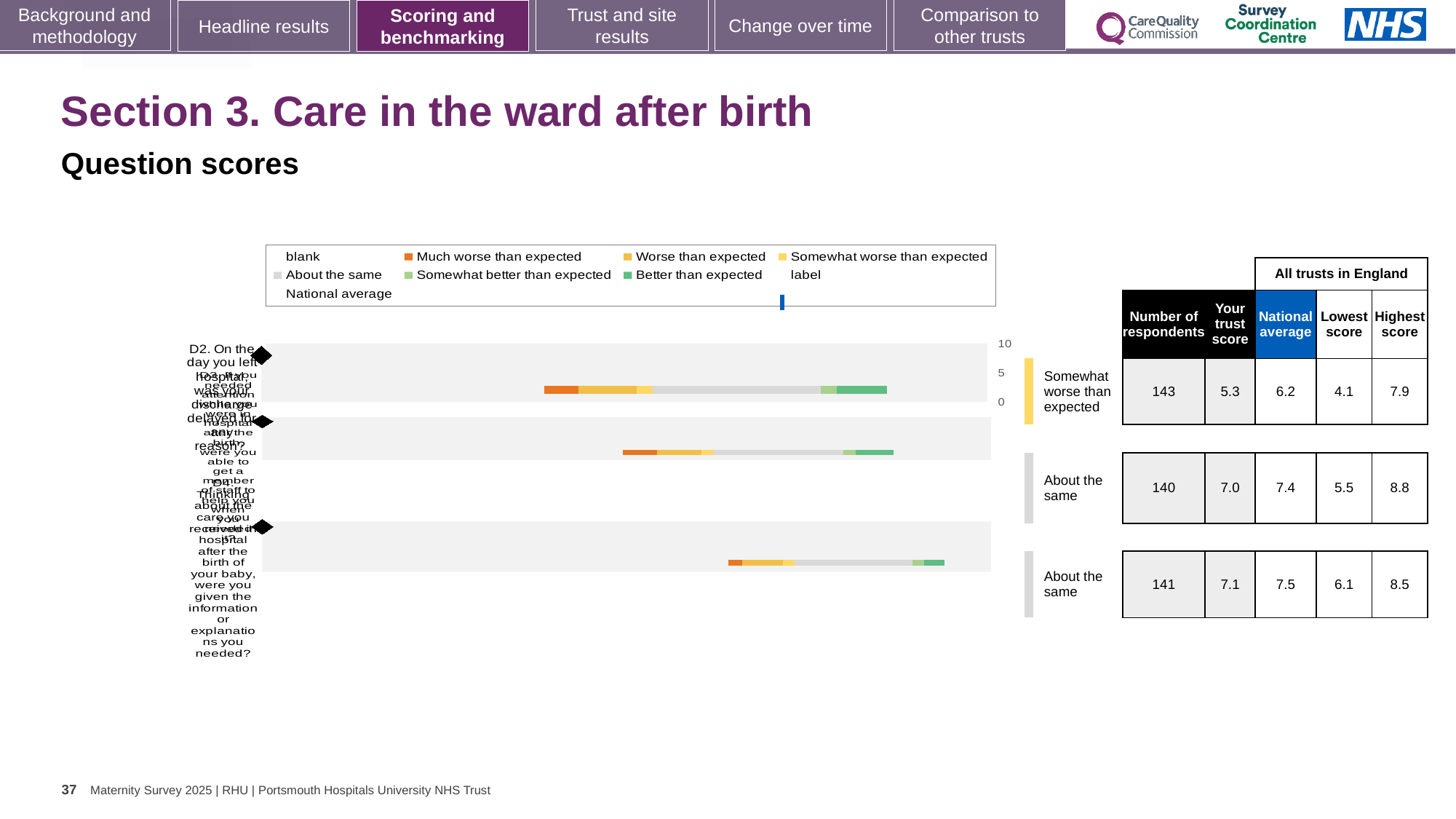
Which bar has the highest 'Your trust score'? the bottom bar (7.1) What kind of chart is shown on the slide? bar chart Which bar has the lowest 'Lowest score' value? the top bar (4.1) How many respondents are listed for the middle bar in the chart? 140 In the chart legend, what colour represents 'Better than expected'? green For the top bar, which is larger: the trust score or the national average? the national average How many bars (question rows) are plotted in the chart? 3 What is the national average for the top bar in the chart? 6.2 What rating label is shown next to the top bar in the chart? Somewhat worse than expected What is the 'Your trust score' value for the top bar in the chart? 5.3 For the bottom bar, what is the difference between the highest score and the lowest score? 2.4 In the chart legend, what colour represents 'Much worse than expected'? orange